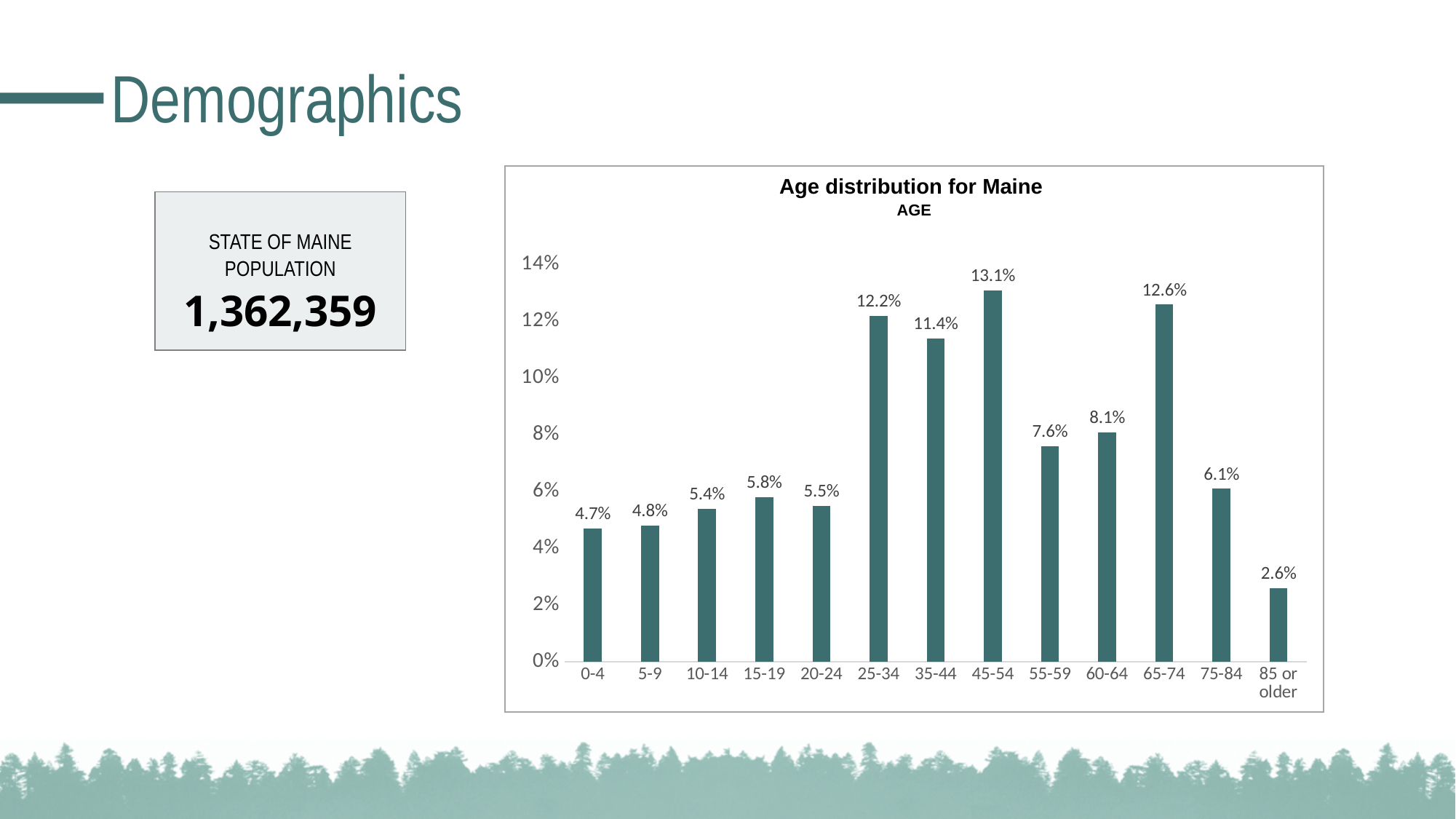
What is the difference between the values for 45-54 and 35-44? 1.7% What kind of chart is shown? bar chart Which age group has the highest value? 45-54 Which age group has the lowest value? 85 or older Is the value for 55-59 greater or less than 8%? less What is the value for the 85 or older age group? 2.6% Which is larger, the value for 65-74 or the value for 25-34? 65-74 What is the difference between the values for 75-84 and 85 or older? 3.5% What is the title of the chart? Age distribution for Maine How many age groups are shown on the x axis? 13 What is the value for the 25-34 age group? 12.2% What is the value for the 60-64 age group? 8.1%